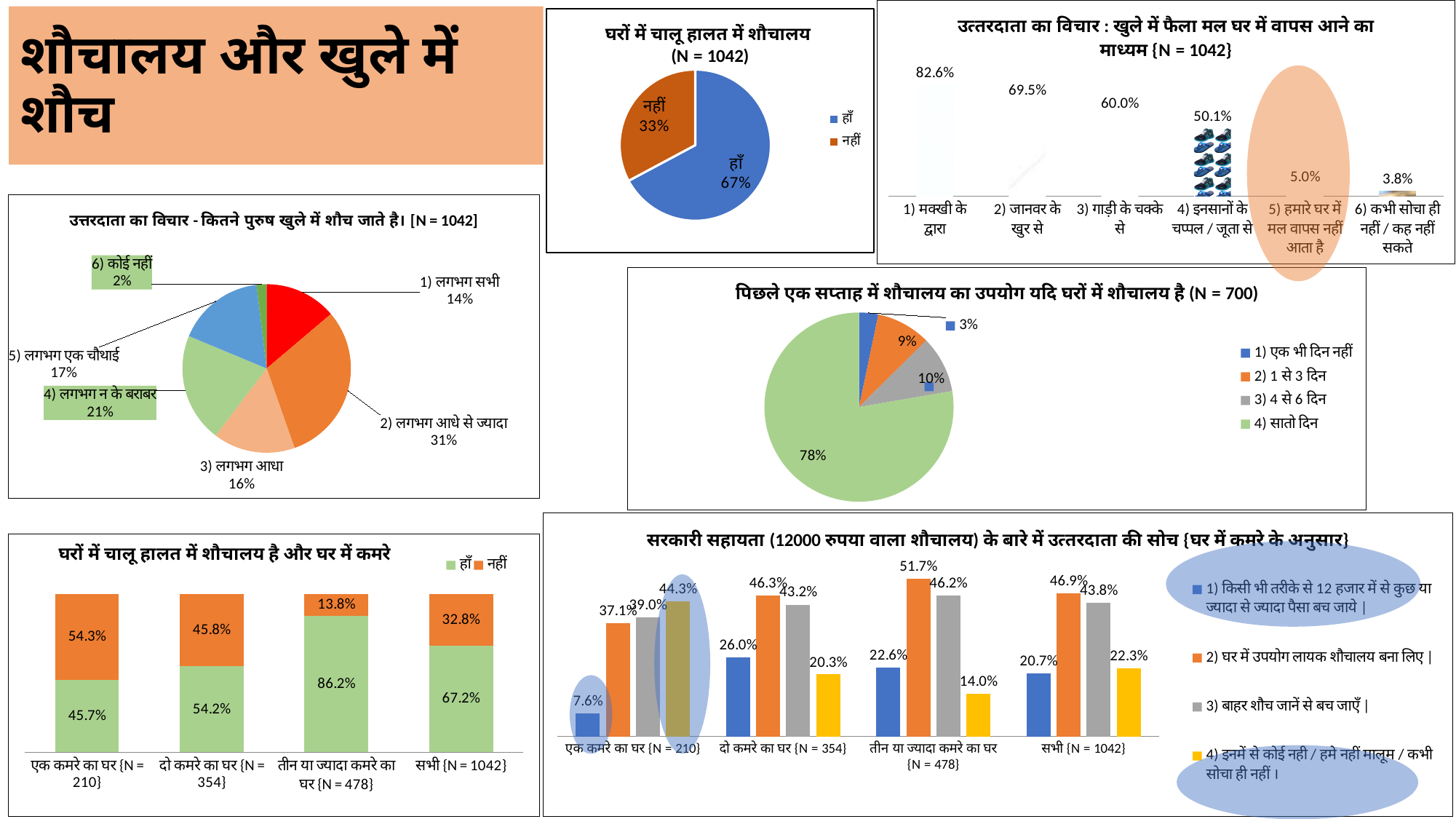
In the pie chart titled 'उत्तरदाता का विचार - कितने पुरुष खुले में शौच जाते है।', what percentage is shown for '4) लगभग न के बराबर'? 21% In the bar chart titled 'उत्तरदाता का विचार : खुले में फैला मल घर में वापस आने का माध्यम', how many categories are shown? 6 In the pie chart titled 'घरों में चालू हालत में शौचालय (N = 1042)', what percentage is shown for 'हाँ'? 67% In the stacked bar chart titled 'घरों में चालू हालत में शौचालय है और घर में कमरे', what is the 'हाँ' value for 'तीन या ज्यादा कमरे का घर {N = 478}'? 86.2% In the pie chart titled 'पिछले एक सप्ताह में शौचालय का उपयोग यदि घरों में शौचालय है (N = 700)', how many entries does the legend list? 4 In the stacked bar chart titled 'घरों में चालू हालत में शौचालय है और घर में कमरे', what is the difference between the 'नहीं' values for 'एक कमरे का घर {N = 210}' and 'दो कमरे का घर {N = 354}'? 8.5% In the bar chart titled 'उत्तरदाता का विचार : खुले में फैला मल घर में वापस आने का माध्यम', what is the value for '1) मक्खी के द्वारा'? 82.6% In the pie chart titled 'उत्तरदाता का विचार - कितने पुरुष खुले में शौच जाते है।', which slice is the largest? 2) लगभग आधे से ज्यादा In the pie chart titled 'पिछले एक सप्ताह में शौचालय का उपयोग यदि घरों में शौचालय है (N = 700)', what percentage is shown for '4) सातो दिन'? 78% What kind of chart is the one titled 'सरकारी सहायता (12000 रुपया वाला शौचालय) के बारे में उत्तरदाता की सोच'? Bar chart In the bar chart titled 'सरकारी सहायता (12000 रुपया वाला शौचालय) के बारे में उत्तरदाता की सोच', what is the value of series '2) घर में उपयोग लायक शौचालय बना लिए' for 'तीन या ज्यादा कमरे का घर {N = 478}'? 51.7% In the bar chart titled 'उत्तरदाता का विचार : खुले में फैला मल घर में वापस आने का माध्यम', which category has the lowest value? 6) कभी सोचा ही नहीं / कह नहीं सकते